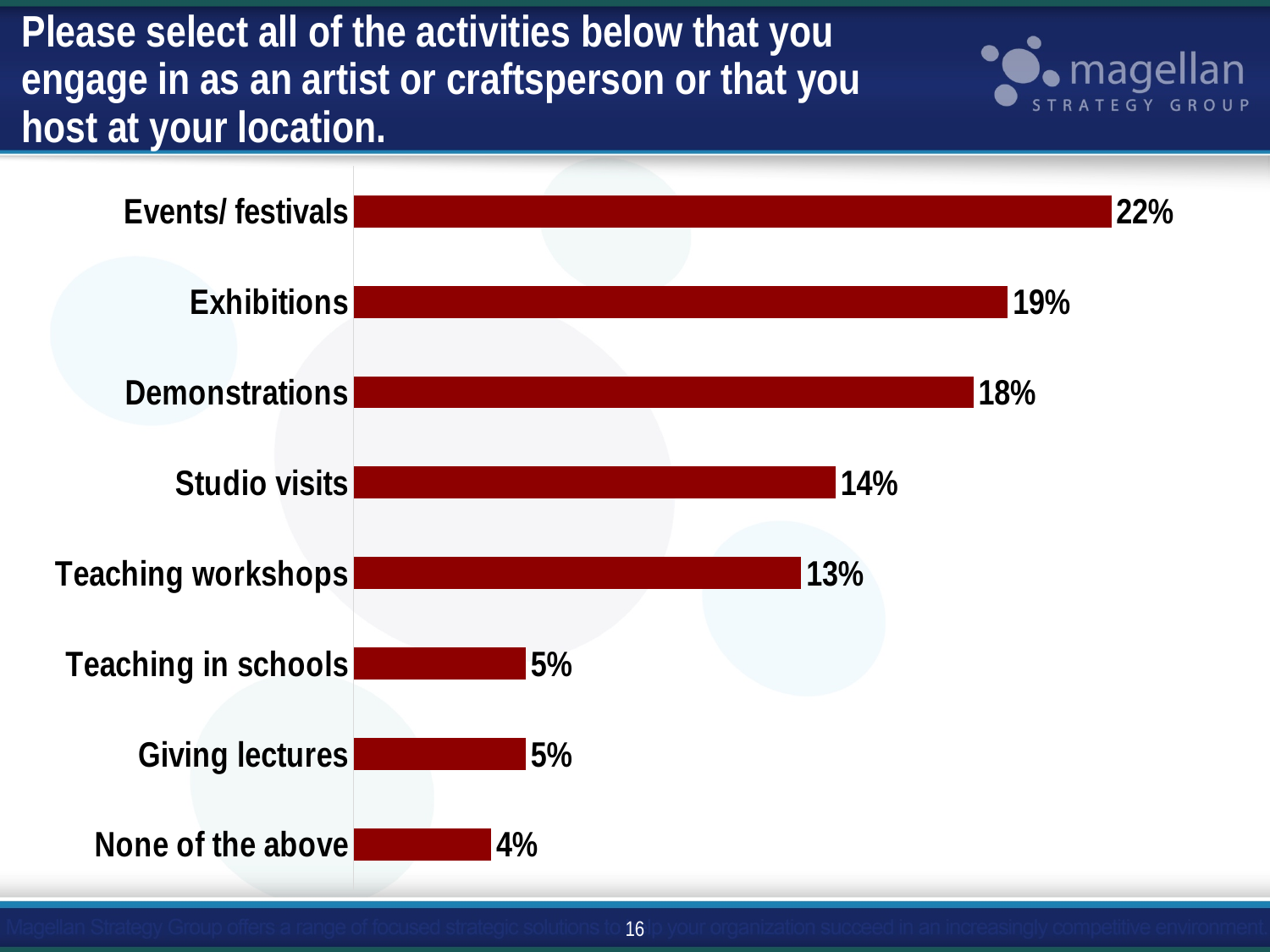
What percentage of respondents selected Events/ festivals? 22% What is the difference between the values for Exhibitions and Demonstrations? 1% What kind of chart is shown on the slide? Bar chart Which activity has the highest percentage? Events/ festivals What is the value shown for Studio visits? 14% How many categories are shown in the chart? 8 Which is larger, the value for Demonstrations or the value for Teaching workshops? Demonstrations What is the value for None of the above? 4% Which two activities share the same value of 5%? Teaching in schools and Giving lectures Which category has the lowest percentage? None of the above What percentage is shown for Teaching workshops? 13% What is the difference between Events/ festivals and Studio visits? 8%